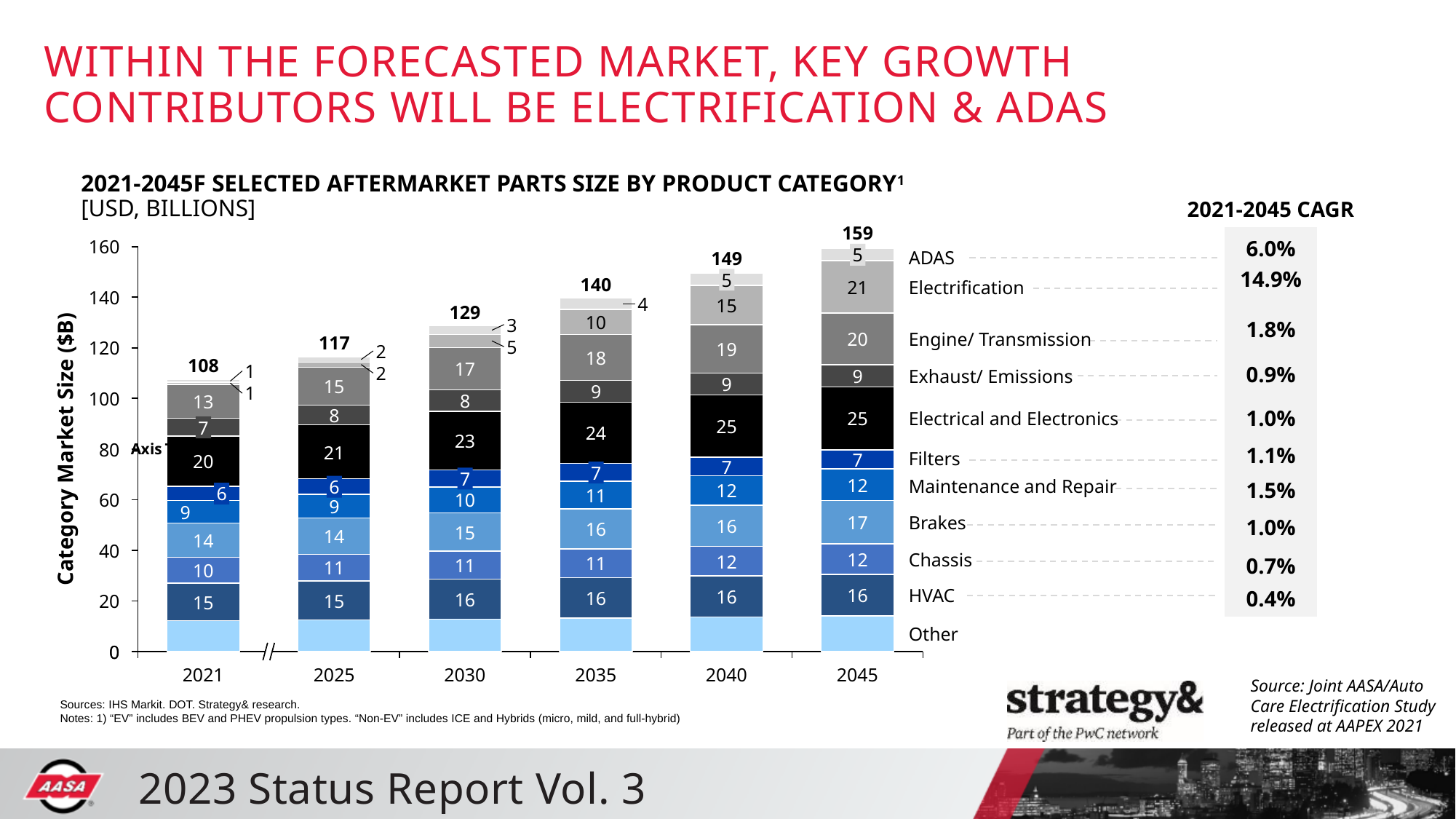
What is the value of the Engine/ Transmission segment in 2030? 17 How many product categories are listed in the legend on the right of the chart? 11 What is the value of the Electrification segment in 2045? 21 What is the difference between the total for 2045 and the total for 2021? 51 How many years are shown on the x axis? 6 What is the value of the Electrical and Electronics segment in 2035? 24 Which year has the highest total bar? 2045 Which product category has the highest 2021-2045 CAGR listed on the slide? Electrification What is the total aftermarket parts size shown for 2045? 159 Which year has the lowest total bar? 2021 Which is larger, the Brakes segment in 2045 or the Brakes segment in 2021? 2045 What kind of chart is used to show the aftermarket parts size by product category? Stacked bar chart